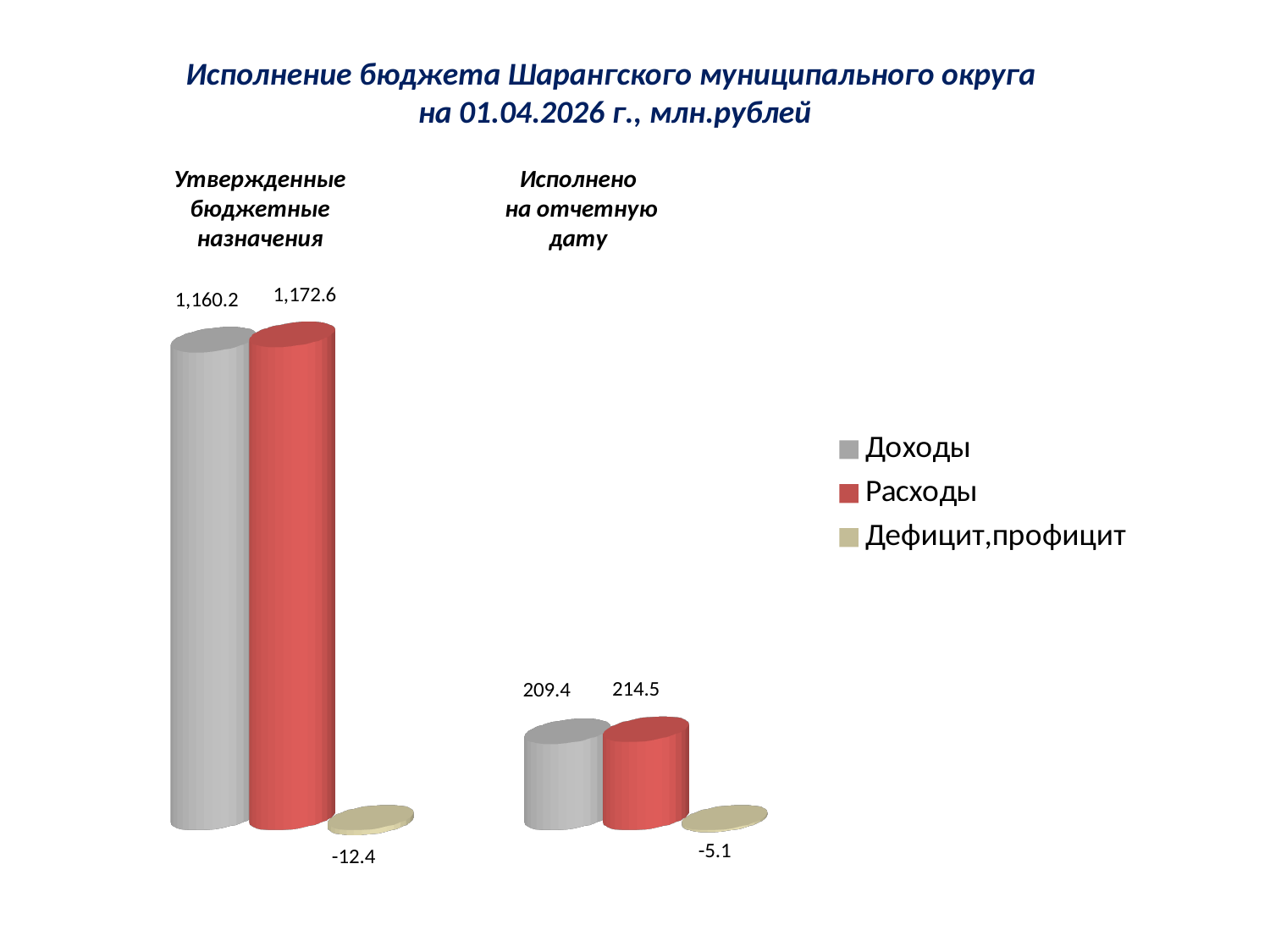
What kind of chart is shown on the slide? Bar chart What is the value of Доходы for Исполнено на отчетную дату? 209.4 How many categories are shown on the x axis? 2 What is the value of Дефицит,профицит for Утвержденные бюджетные назначения? -12.4 Which is larger for Утвержденные бюджетные назначения: Доходы or Расходы? Расходы How many series does the legend list? 3 What is the value of Дефицит,профицит for Исполнено на отчетную дату? -5.1 Which series has the highest value for Исполнено на отчетную дату? Расходы Which series has the lowest value for Утвержденные бюджетные назначения? Дефицит,профицит What is the value of Расходы for Утвержденные бюджетные назначения? 1,172.6 What is the difference between Расходы and Доходы for Исполнено на отчетную дату? 5.1 What is the value of Доходы for Утвержденные бюджетные назначения? 1,160.2